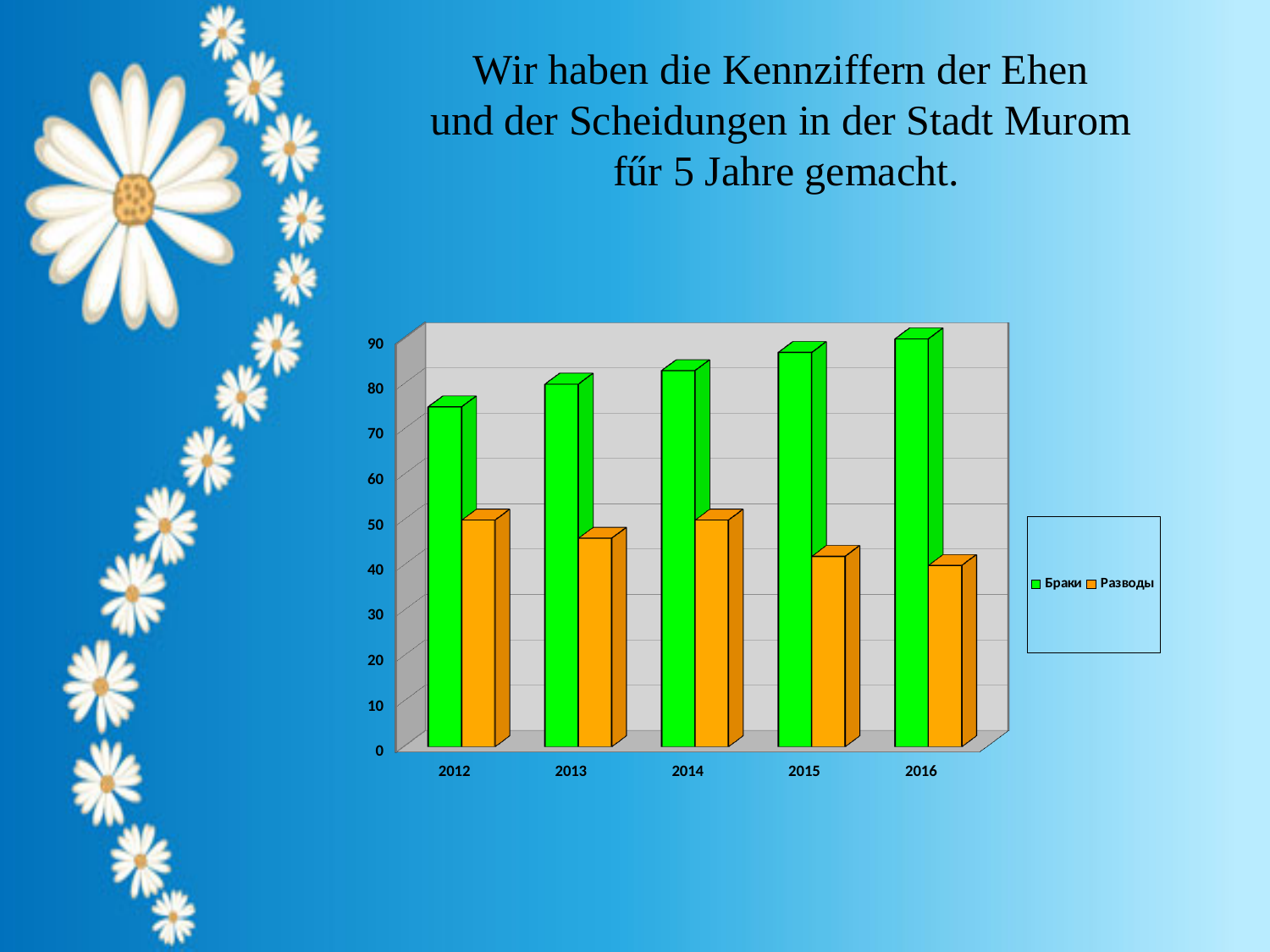
Which year has the lowest value for Браки? 2012 In 2012, which is larger: Браки or Разводы? Браки Is the value for Разводы in 2015 greater or less than 50? less Do the values for Браки rise or fall from 2012 to 2016? rise How many series does the chart's legend list? 2 Is the value for Браки in 2012 greater or less than 70? greater Is the value for Разводы in 2016 greater or less than 50? less What kind of chart is shown on the slide? bar chart Which year has the highest value for Браки? 2016 What colour are the bars for the Браки series? green How many years are shown on the x axis of the chart? 5